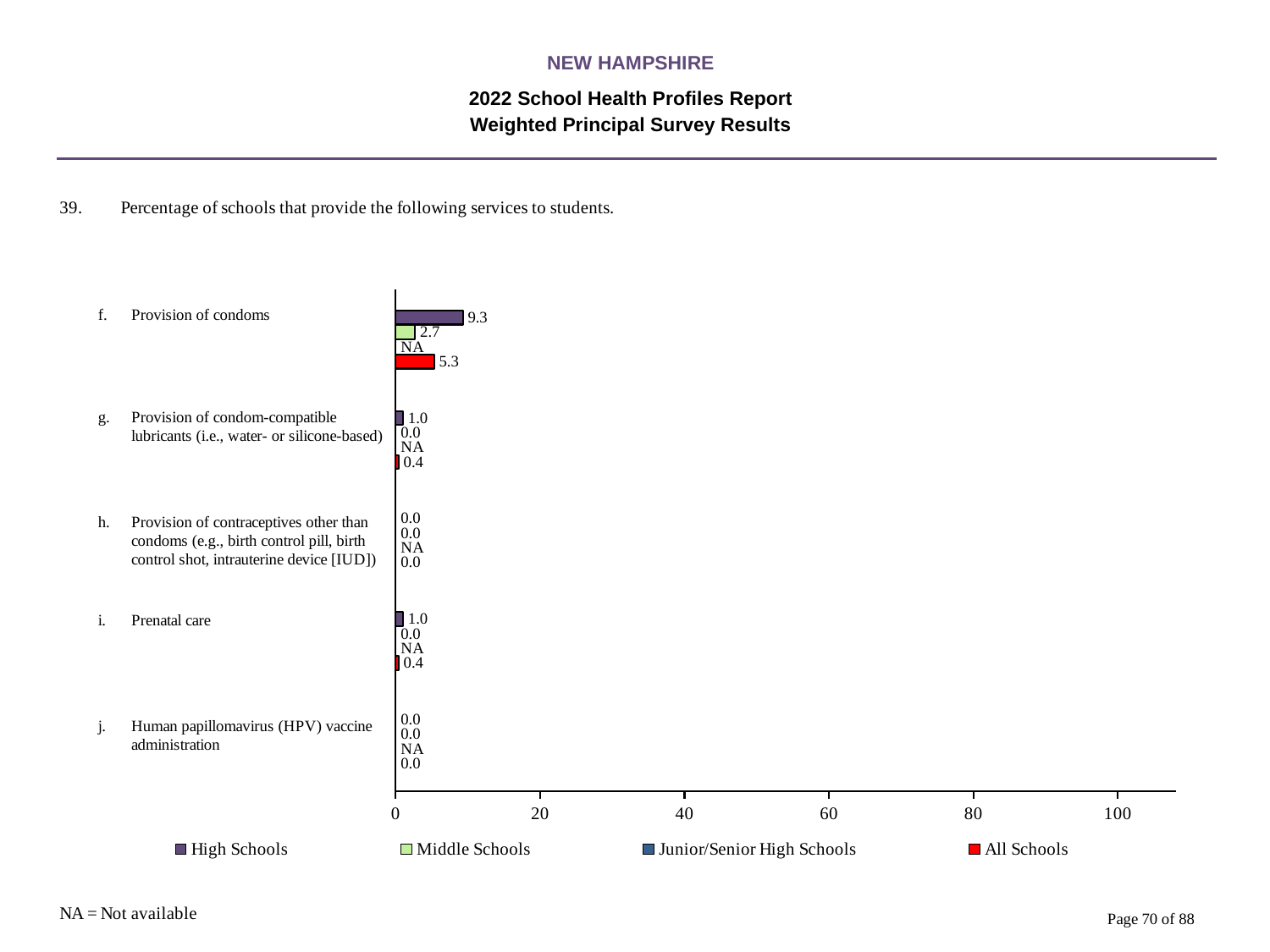
What is the All Schools value for Provision of condom-compatible lubricants? 0.4 How many services are listed on the chart? 5 Which service has the highest High Schools value? Provision of condoms For Provision of condoms, which is larger: the High Schools value or the All Schools value? High Schools How many series does the legend list? 4 What is the All Schools value for Provision of condoms? 5.3 What is the High Schools value for Prenatal care? 1.0 What is the difference between the High Schools and Middle Schools values for Provision of condoms? 6.6 What kind of chart is shown? Bar chart What is the Junior/Senior High Schools value for Human papillomavirus (HPV) vaccine administration? NA What is the Middle Schools value for Provision of condoms? 2.7 What is the High Schools value for Provision of condoms? 9.3